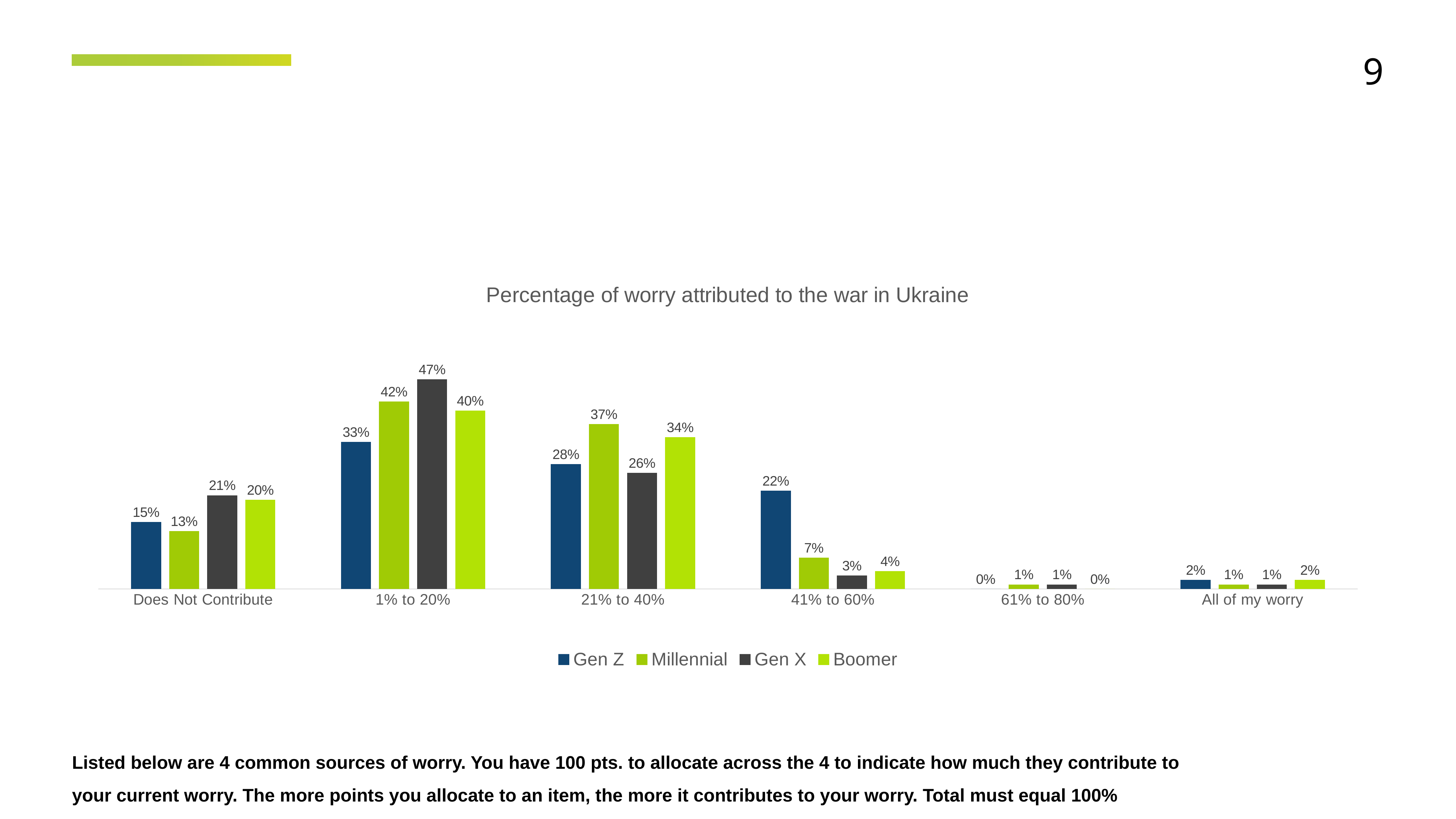
What is the difference between the Millennial and Gen Z values in the "1% to 20%" category? 9% What is the value for Boomer in the "21% to 40%" category? 34% What is the value for Gen X in the "1% to 20%" category? 47% What is the title of the chart? Percentage of worry attributed to the war in Ukraine How many categories are shown on the x axis? 6 Which is larger in the "21% to 40%" category: Gen Z or Millennial? Millennial What is the value for Gen Z in the "41% to 60%" category? 22% Which series has the highest value in the "Does Not Contribute" category? Gen X Which series has the lowest value in the "41% to 60%" category? Gen X How many series does the legend list? 4 What kind of chart is shown on the slide? Bar chart What is the difference between the Gen X and Millennial values in the "21% to 40%" category? 11%